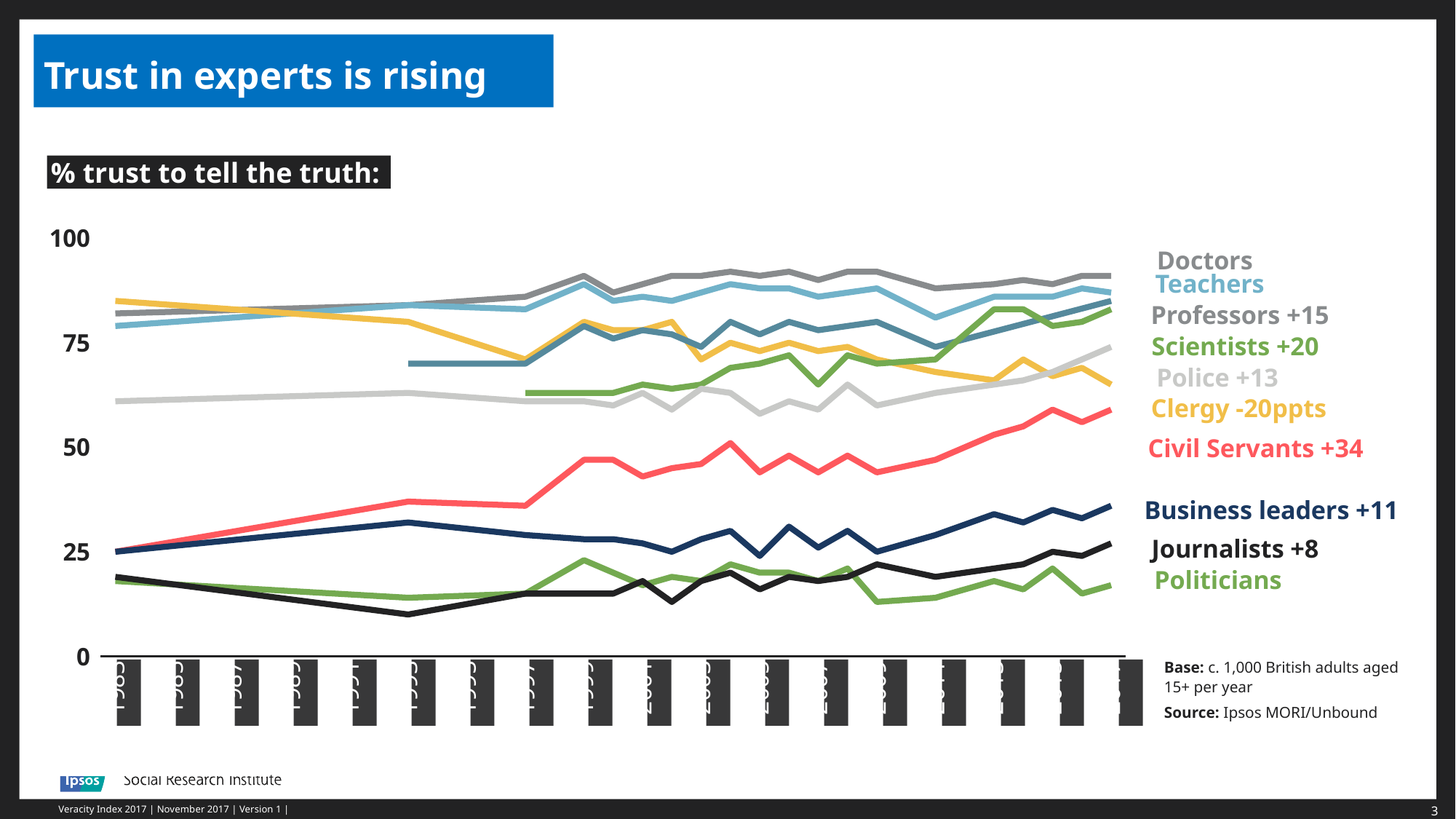
What is the title of the slide? Trust in experts is rising What kind of chart is shown on the slide? line chart At the right-hand end of the chart, which is larger: Civil Servants or Business leaders? Civil Servants Which series has the highest value at the right-hand end of the chart? Doctors Is the value for Doctors at the right-hand end of the chart greater or less than 75? greater Is the value for Politicians at the right-hand end of the chart greater or less than 25? less Is the value for Business leaders at the right-hand end of the chart greater or less than 25? greater Which series has the lowest value at the right-hand end of the chart? Politicians How many series does the legend list? 10 Does the Civil Servants line rise or fall overall from left to right? rise Does the Clergy line rise or fall overall from left to right? fall